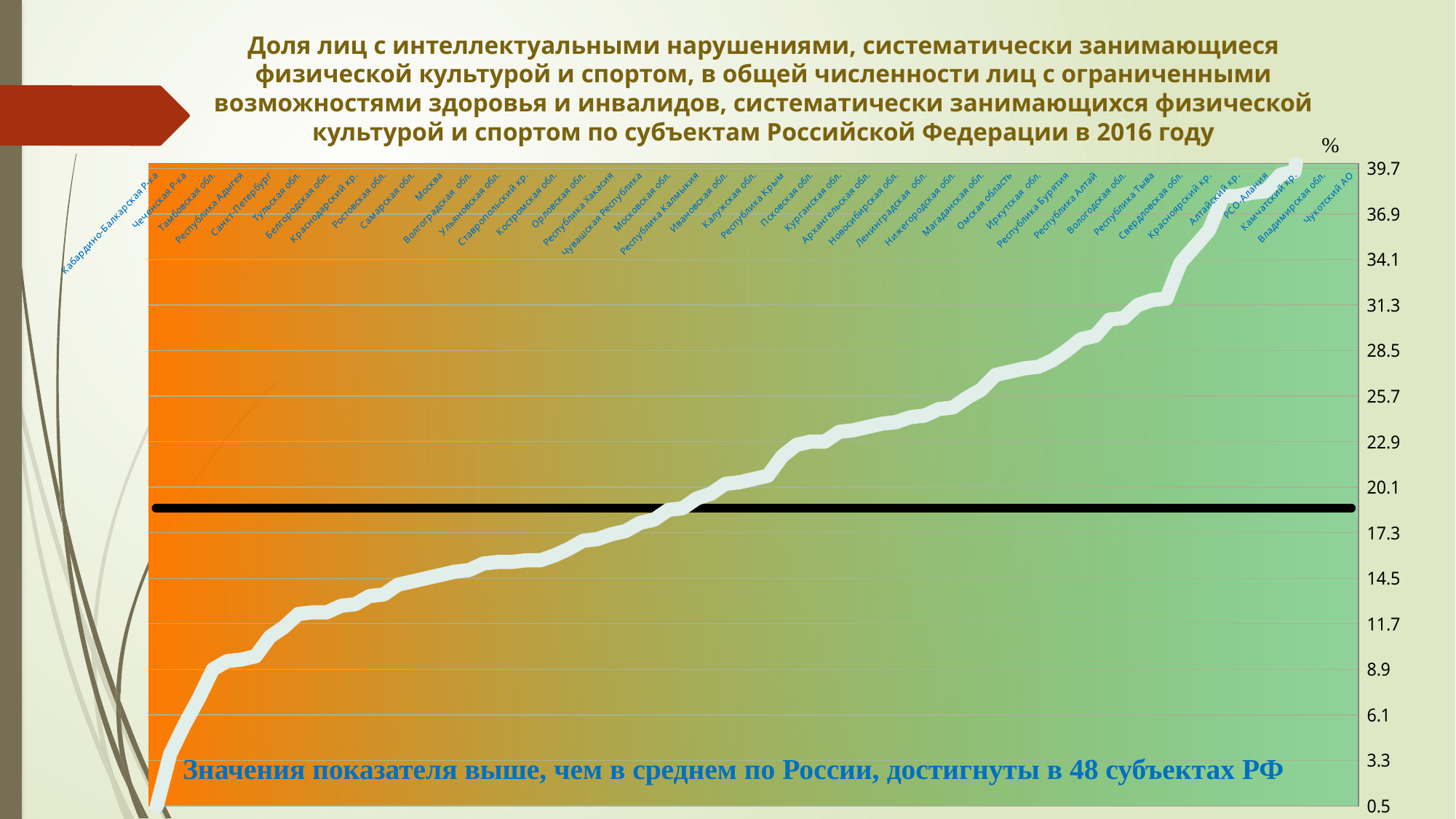
Which has the larger value, Москва or Омская область? Омская область According to the text on the chart, in how many subjects of the Russian Federation is the indicator above the Russian average? 48 Is the value for Чукотский АО greater or less than 36.9? greater Which region is plotted at the far left of the chart, with the lowest value? Кабардино-Балкарская Р-ка What kind of chart is shown on the slide? line chart Is the black horizontal line (the Russian average) above or below the 20.1 gridline? below Which has the larger value, Чеченская Р-ка or Камчатский кр.? Камчатский кр. What is the highest tick value shown on the vertical axis? 39.7 What unit is indicated at the top of the vertical axis? % Which region is plotted at the far right of the chart, with the highest value? Чукотский АО Is the value for Кабардино-Балкарская Р-ка greater or less than 3.3? less Do the values rise or fall moving from left to right along the x axis? rise